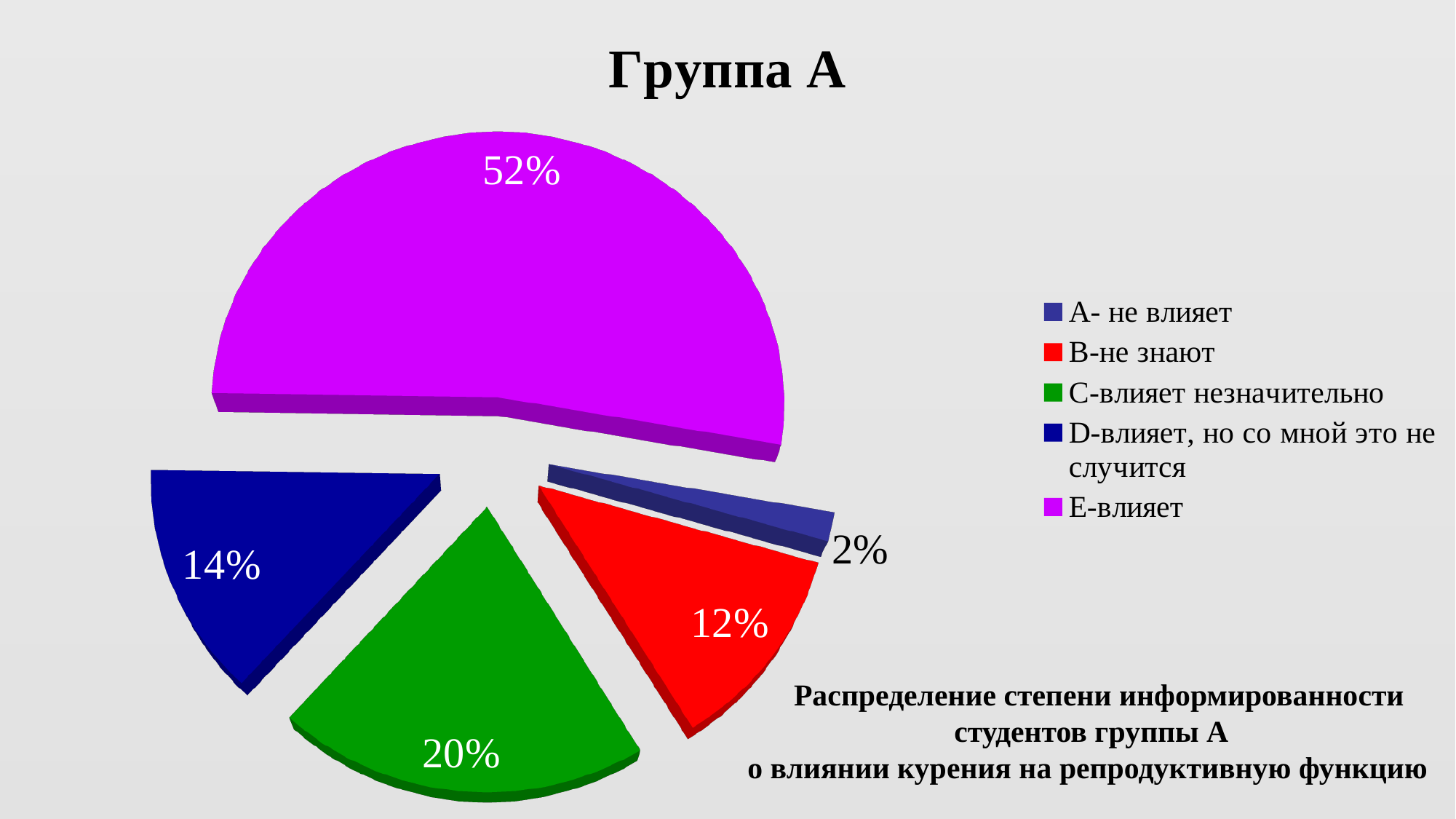
How many slices does the pie chart have? 5 What is the title of the chart? Группа А What is the difference between the values for "E-влияет" and "C-влияет незначительно"? 32% Which category has the smallest slice? A- не влияет What is the value shown for "C-влияет незначительно"? 20% What is the value shown for "B-не знают"? 12% How many entries does the legend list? 5 What is the value shown for "D-влияет, но со мной это не случится"? 14% What is the value shown for "A- не влияет"? 2% Which category has the largest slice? E-влияет What share of the pie is labelled for "E-влияет"? 52% What kind of chart is shown on the slide? pie chart